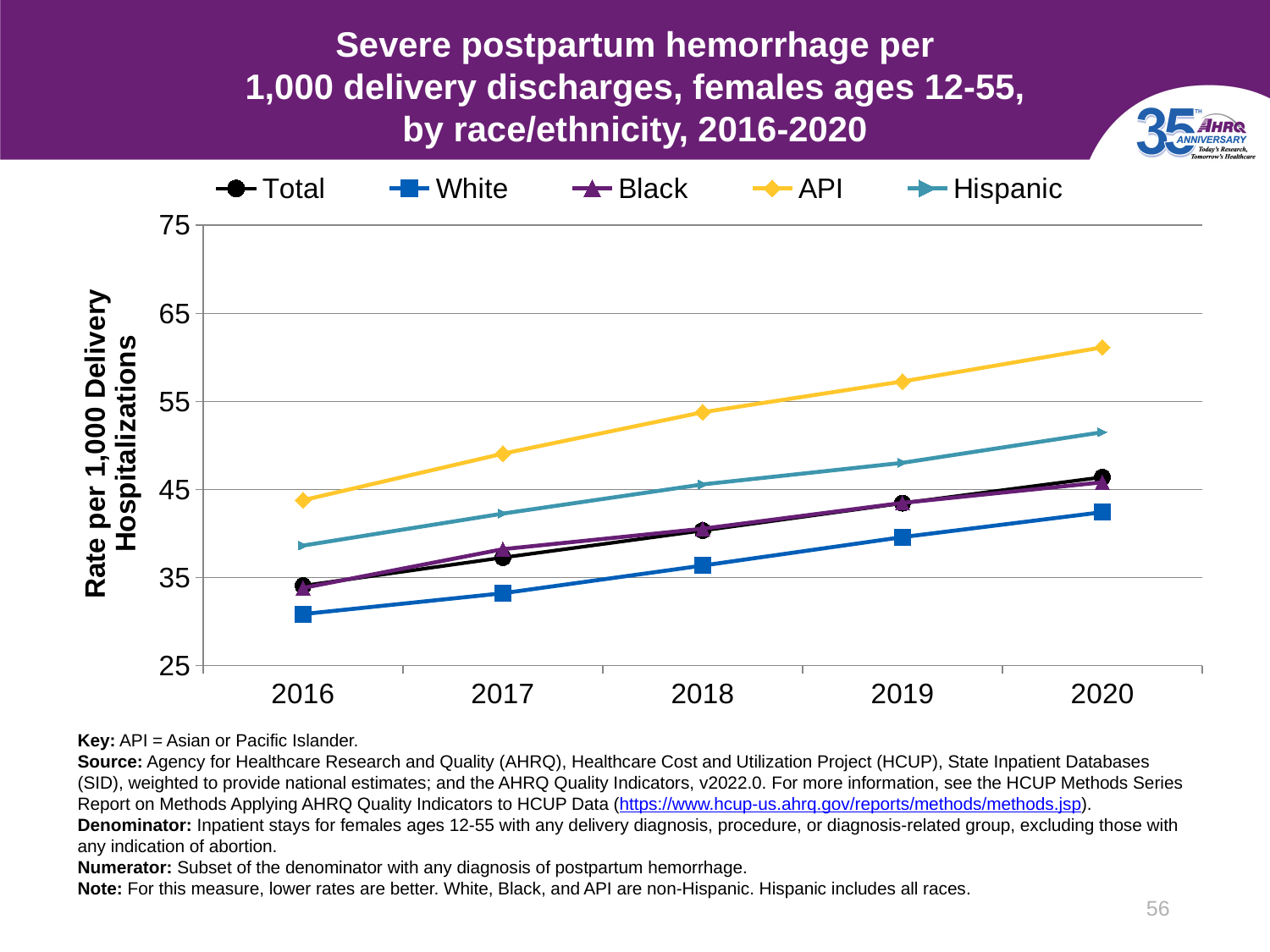
Which race/ethnicity group has the lowest rate in 2020? White Do the rates for the Total series rise or fall from 2016 to 2020? rise Is the value for API in 2020 greater or less than 55? greater Is the value for Hispanic in 2020 greater or less than 45? greater Which is larger in 2018, the rate for API or the rate for White? API Is the value for White in 2020 greater or less than 45? less How many years are plotted along the x axis? 5 What kind of chart is shown on the slide? line chart Which race/ethnicity group has the highest rate in 2020? API What is the label on the y axis? Rate per 1,000 Delivery Hospitalizations How many series does the legend list? 5